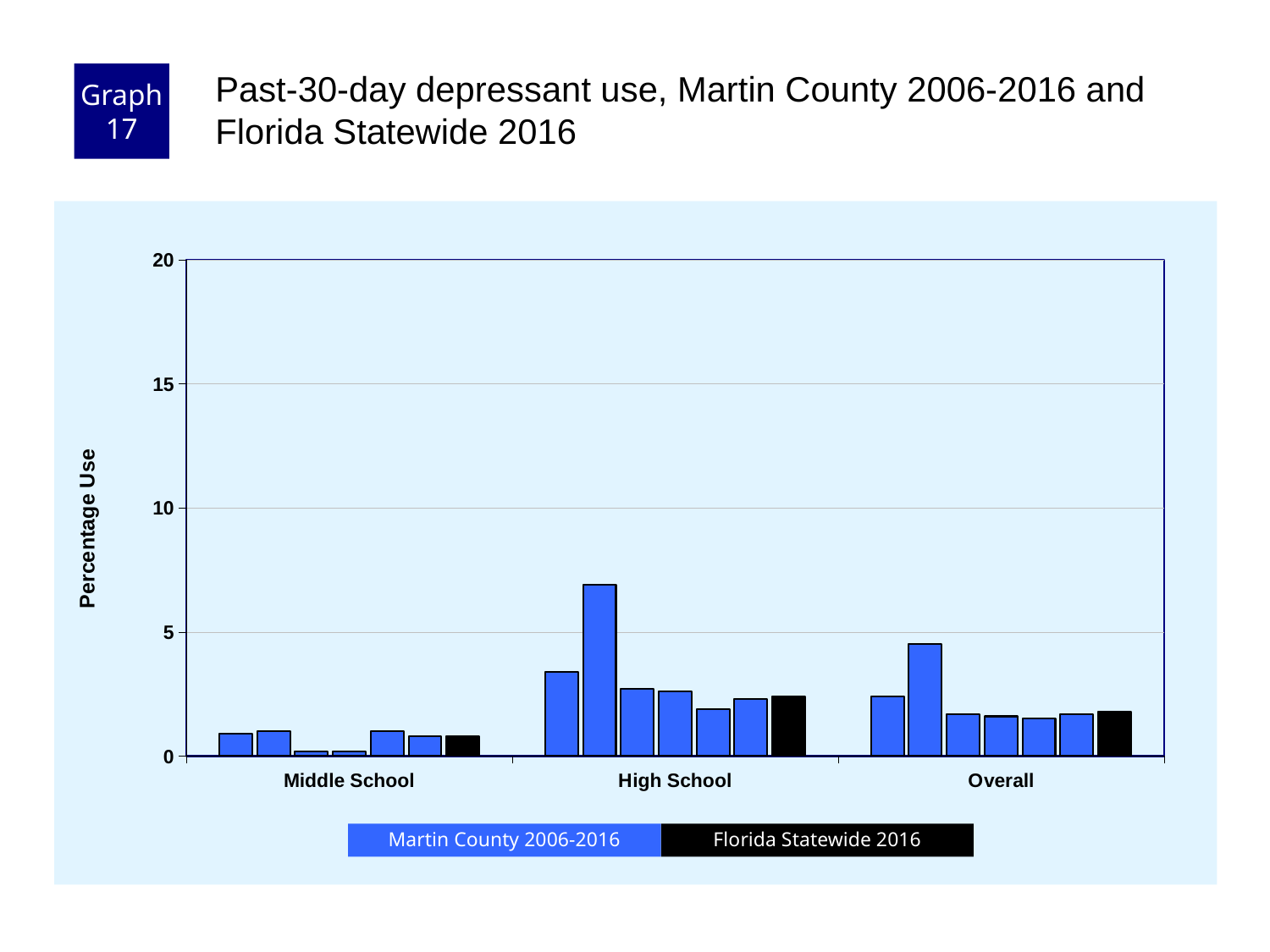
Which category group contains the shortest bars in the chart? Middle School Is the tallest Martin County bar in the High School group greater or less than 5? greater What colour are the Florida Statewide 2016 bars? black How many series does the legend list? 2 How many school-level categories are shown on the x axis? 3 Which is larger, the Florida Statewide 2016 value for High School or for Overall? High School Which is larger, the Florida Statewide 2016 value for High School or for Middle School? High School Which category group contains the tallest bar in the chart? High School Is the Florida Statewide 2016 value for High School greater or less than 5? less What is the label on the y axis? Percentage Use What kind of chart is shown on the slide? bar chart Is the Florida Statewide 2016 value for Middle School greater or less than 5? less